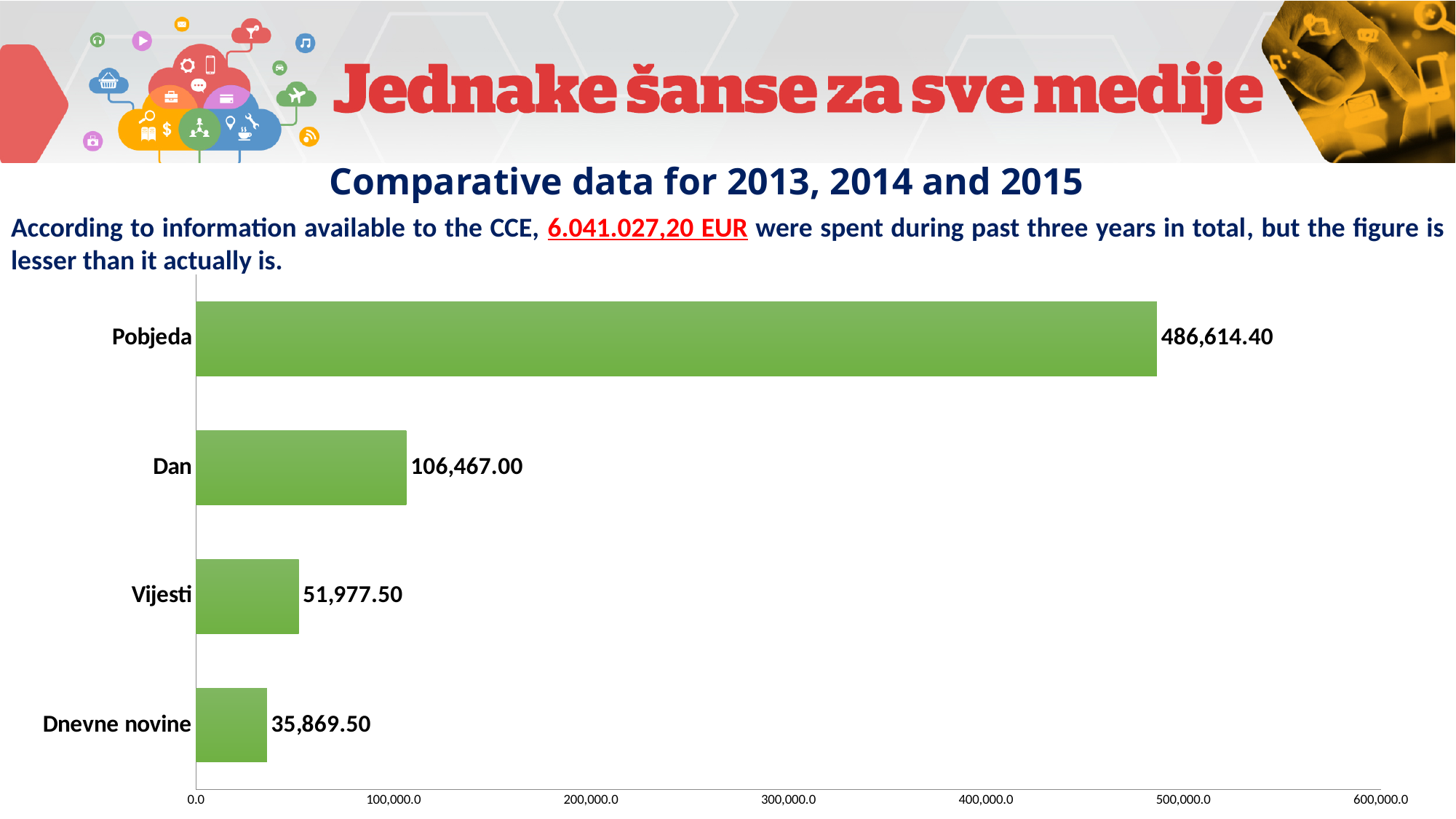
What is the value for Pobjeda? 486,614.40 What is the value for Dnevne novine? 35,869.50 What is the difference between the values for Pobjeda and Dan? 380,147.40 Is the value for Pobjeda greater or less than 400,000.0? greater Which category has the highest value? Pobjeda What kind of chart is shown on the slide? bar chart Which category has the lowest value? Dnevne novine What is the difference between the values for Vijesti and Dnevne novine? 16,108.00 What is the value for Vijesti? 51,977.50 How many categories are shown in the chart? 4 Which is larger, the value for Dan or the value for Vijesti? Dan What is the value for Dan? 106,467.00